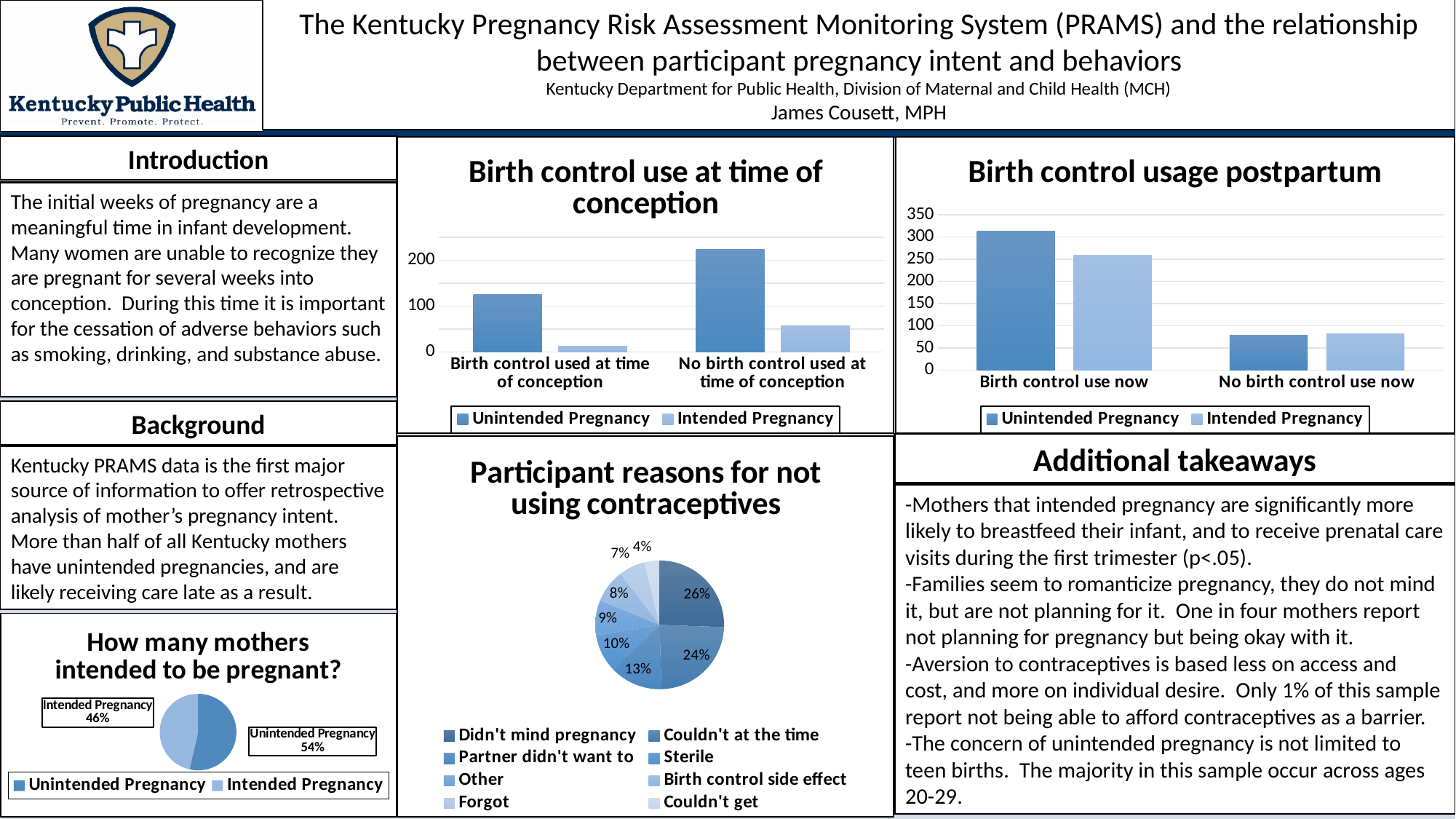
In the chart 'How many mothers intended to be pregnant?', by how many percentage points does Unintended Pregnancy exceed Intended Pregnancy? 8 percentage points In the chart 'How many mothers intended to be pregnant?', which is larger: the Unintended Pregnancy share or the Intended Pregnancy share? Unintended Pregnancy In the 'Birth control usage postpartum' chart, is the Unintended Pregnancy value for 'Birth control use now' greater or less than 300? greater In the 'Birth control use at time of conception' chart, is the Unintended Pregnancy value for 'No birth control used at time of conception' greater or less than 200? greater What kind of chart is 'Participant reasons for not using contraceptives'? Pie chart How many reasons does the legend of the 'Participant reasons for not using contraceptives' chart list? 8 In the 'Participant reasons for not using contraceptives' pie chart, what is the percentage of the largest slice? 26% In the chart 'How many mothers intended to be pregnant?', what percentage of mothers had an intended pregnancy? 46% In the 'Birth control use at time of conception' chart, is the Intended Pregnancy value for 'Birth control used at time of conception' greater or less than 100? less In the chart 'How many mothers intended to be pregnant?', what percentage of mothers had an unintended pregnancy? 54% In the 'Participant reasons for not using contraceptives' pie chart, what is the percentage of the smallest slice? 4% In the 'Birth control usage postpartum' chart, which series has the larger value for 'Birth control use now': Unintended Pregnancy or Intended Pregnancy? Unintended Pregnancy